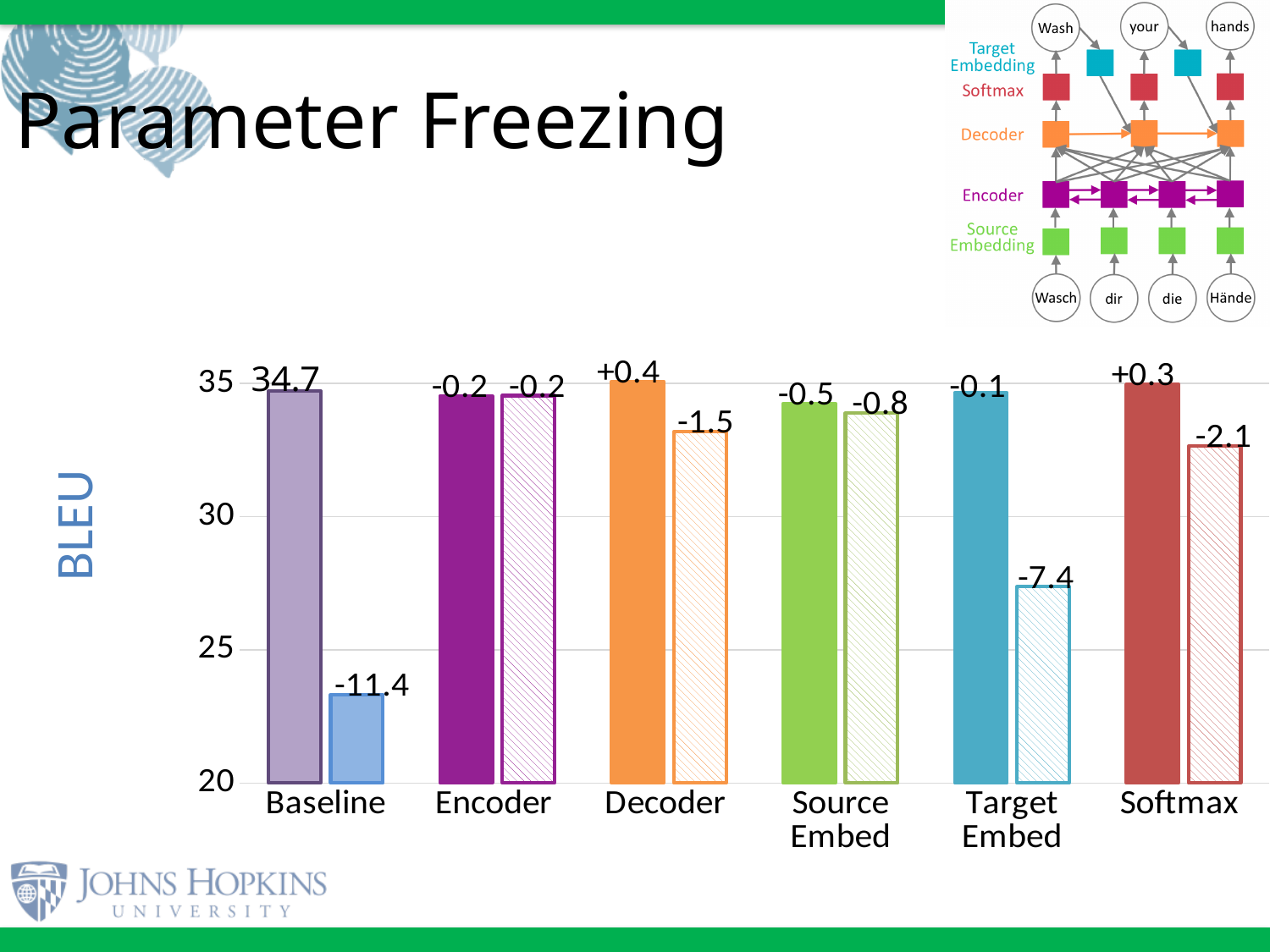
What change is printed on the hatched Softmax bar? -2.1 What change is printed on the hatched Target Embed bar? -7.4 What change is printed on the hatched Baseline bar? -11.4 How many categories are shown on the x axis of the chart? 6 What change is printed on the solid Decoder bar? +0.4 Is the value of the hatched Target Embed bar greater or less than 30? less What BLEU value is printed on the solid Baseline bar? 34.7 Which category has the bar with the lowest BLEU value in the chart? Baseline What is the label on the y axis of the chart? BLEU Is the value of the hatched Softmax bar greater or less than 30? greater What change is printed on the hatched Source Embed bar? -0.8 What kind of chart is shown on the slide? bar chart